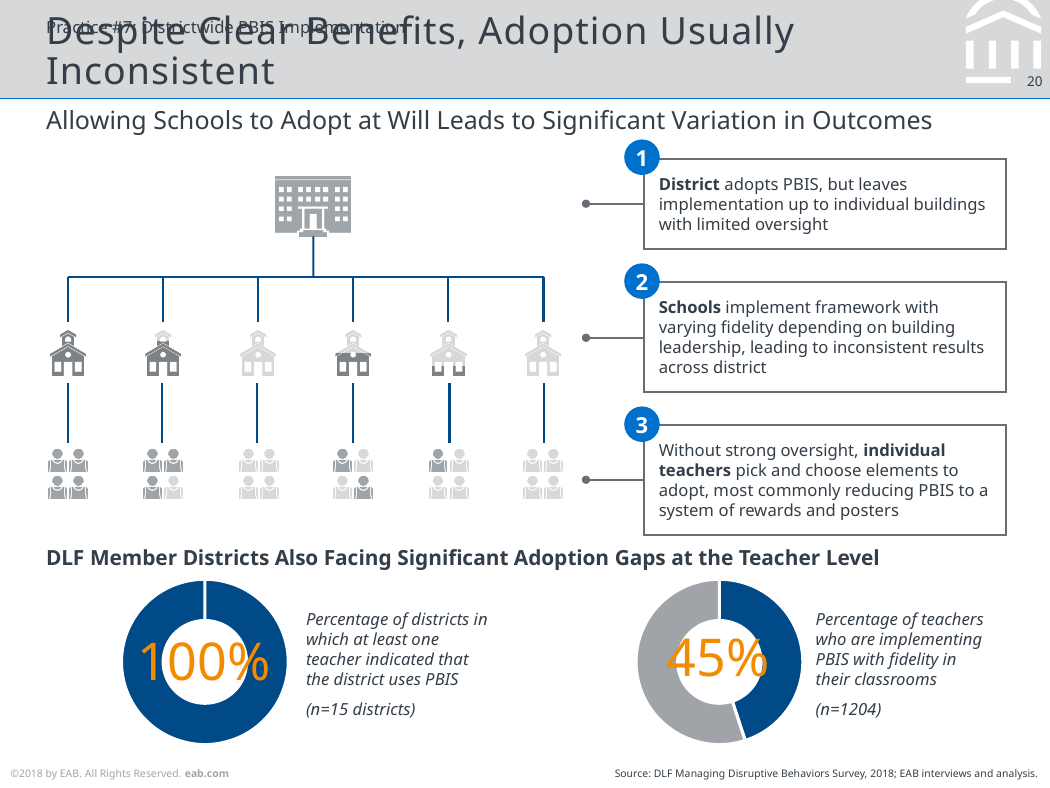
Which is larger: the percentage shown in the left donut chart or the percentage shown in the right donut chart? The left donut chart (100%) How many donut charts are shown on the slide? 2 On the right donut chart, what share of the ring is not filled in blue (i.e., teachers not implementing PBIS with fidelity)? 55% What is the sample size (n) for the right donut chart on teachers implementing PBIS with fidelity? n=1204 What is the sample size (n) for the left donut chart on districts using PBIS? n=15 districts On the right donut chart, what percentage of teachers are implementing PBIS with fidelity in their classrooms? 45% On the left donut chart, what percentage of districts had at least one teacher indicate that the district uses PBIS? 100% What kind of chart is used to show the percentage of teachers implementing PBIS with fidelity? Donut (pie) chart Is the value shown in the right donut chart greater or less than 50%? less What is the difference between the percentage of districts using PBIS (left chart) and the percentage of teachers implementing PBIS with fidelity (right chart)? 55 percentage points